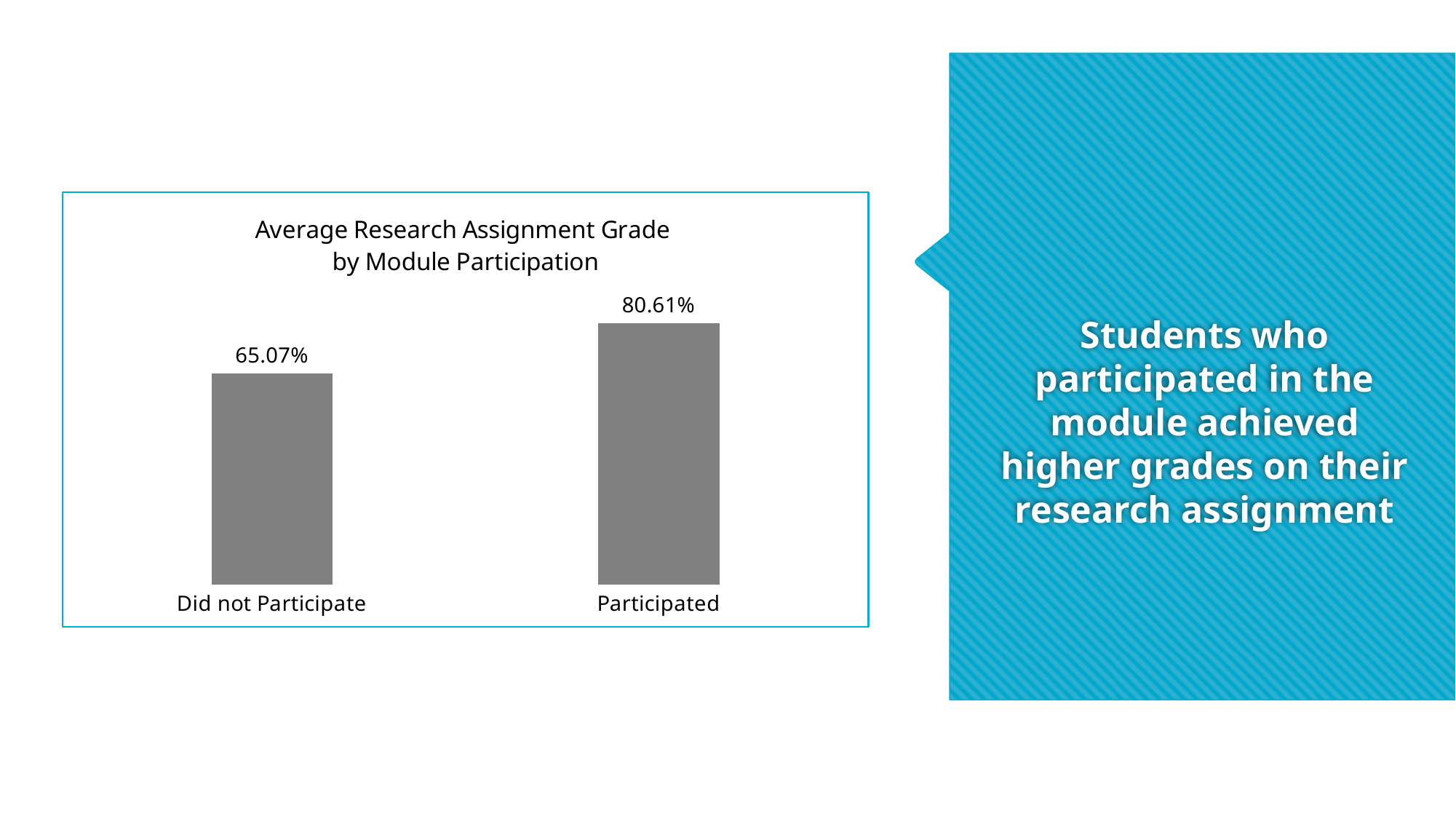
Is the average grade higher for Participated or Did not Participate? Participated What is the difference between the average grade for Participated and Did not Participate? 15.54% Which category has the lower average research assignment grade? Did not Participate What kind of chart is shown on the slide? Bar chart How many categories are shown in the chart? 2 What is the title of the chart? Average Research Assignment Grade by Module Participation Which category has the higher average research assignment grade? Participated What colour are the bars in the chart? Grey What is the average research assignment grade for students who did not participate? 65.07% What is the average research assignment grade for students who participated? 80.61%